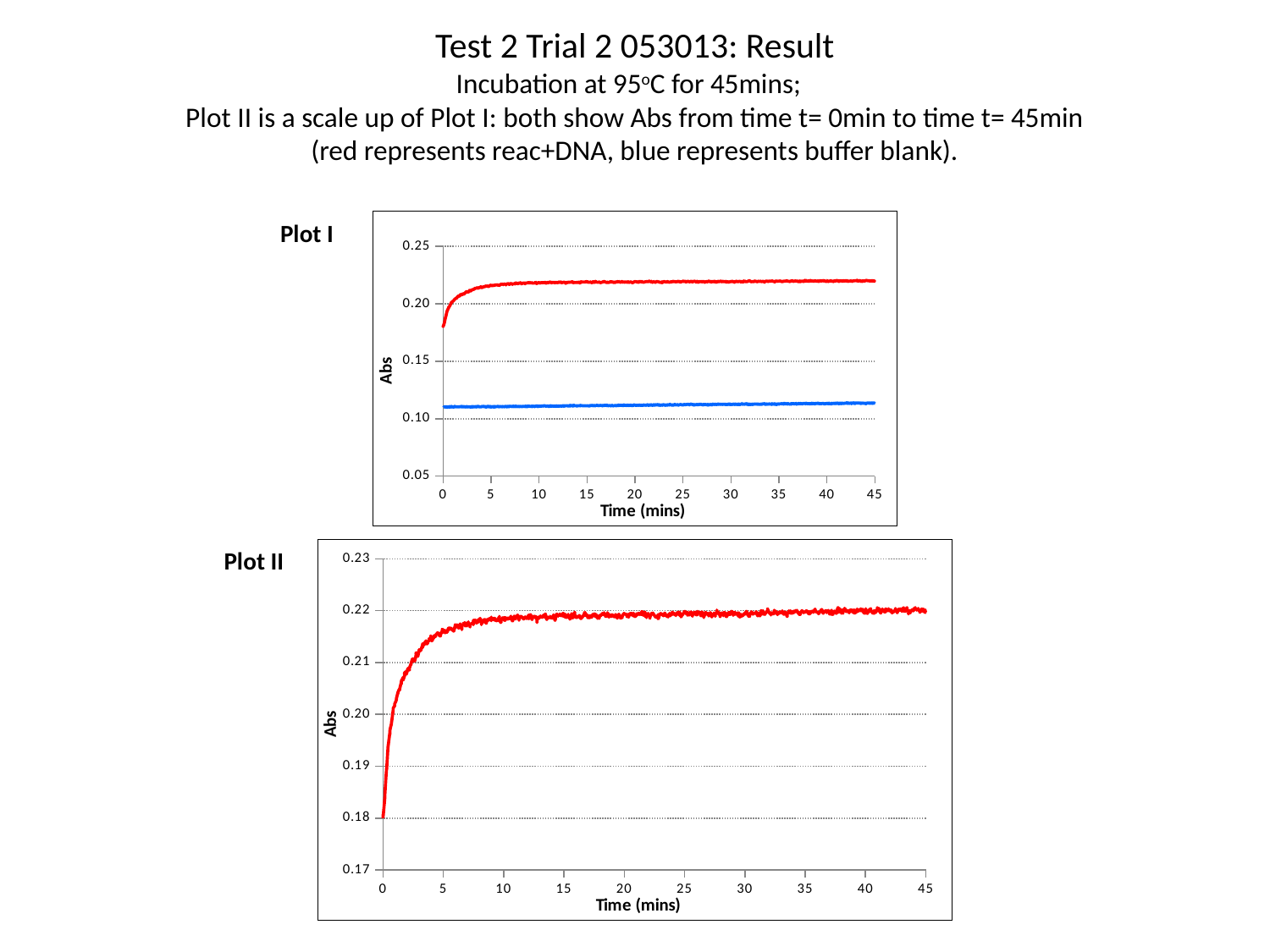
In Plot II, is the value of the red line at 0 minutes greater or less than 0.19? less In Plot I, is the red line (reac+DNA) above or below the blue line (buffer blank) throughout the 45 minutes? above What kind of chart is Plot II? line chart What kind of chart is Plot I? line chart How many lines are plotted in Plot II? 1 What is the x-axis label of Plot II? Time (mins) What is the y-axis label of Plot I? Abs How many lines are plotted in Plot I? 2 In Plot I, is the value of the blue line at 45 minutes greater or less than 0.15? less In Plot II, is the value of the red line at 45 minutes greater or less than 0.21? greater In Plot II, does the red line rise or fall between 0 and 5 minutes? rise